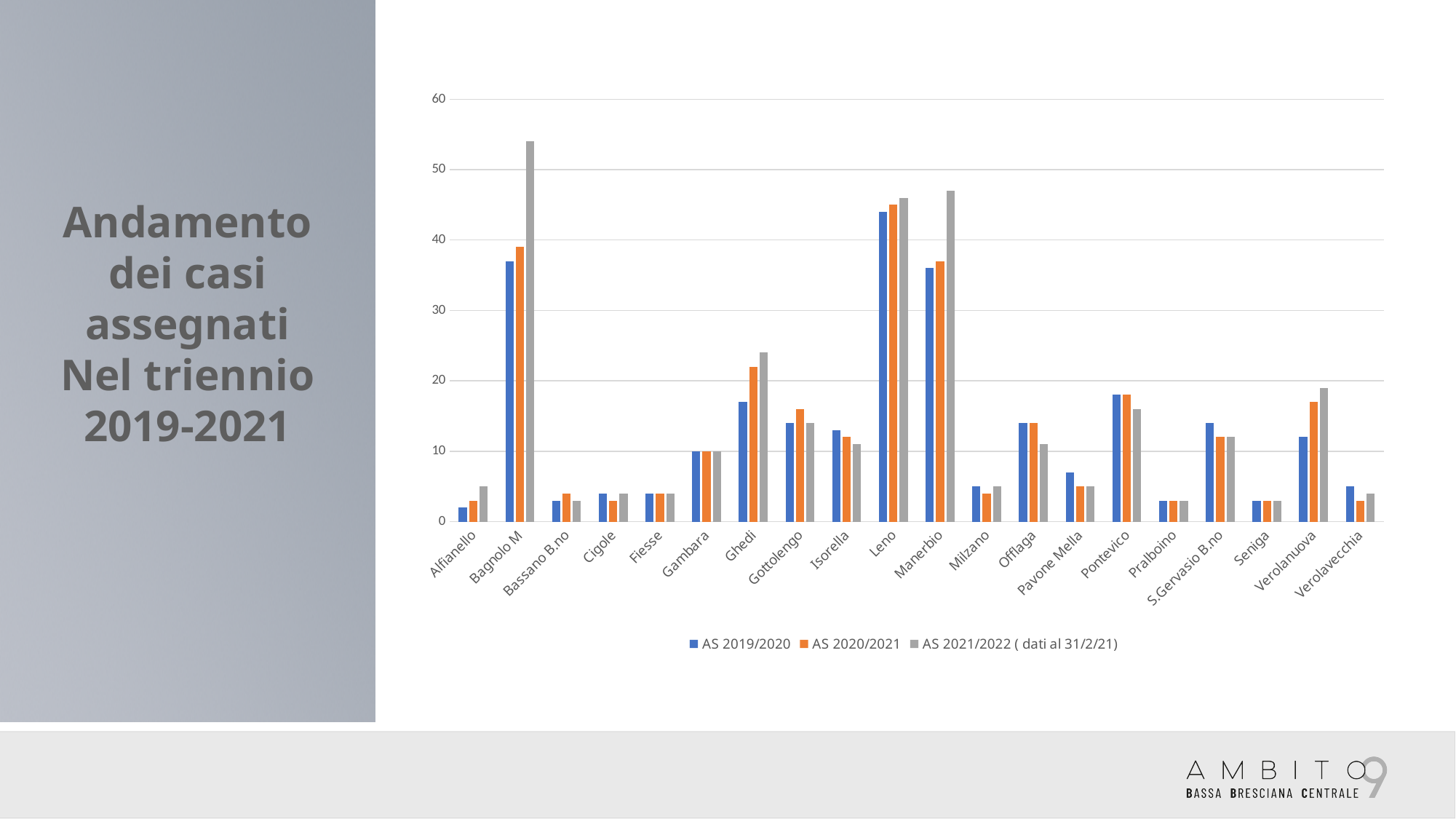
Is the value for Leno in AS 2019/2020 greater or less than 40? greater How many series does the legend list? 3 Is the value for Ghedi in AS 2021/2022 ( dati al 31/2/21) greater or less than 20? greater What is the title of the slide containing the chart? Andamento dei casi assegnati Nel triennio 2019-2021 Which municipality has the highest value for AS 2019/2020? Leno Which municipality has the highest value for AS 2021/2022 ( dati al 31/2/21)? Bagnolo M What kind of chart is shown on the slide? bar chart Is the value for Bagnolo M in AS 2021/2022 ( dati al 31/2/21) greater or less than 50? greater Which municipality has the highest value for AS 2020/2021? Leno For AS 2021/2022 ( dati al 31/2/21), which is larger: Ghedi or Gottolengo? Ghedi How many municipalities (categories) are shown on the x axis? 20